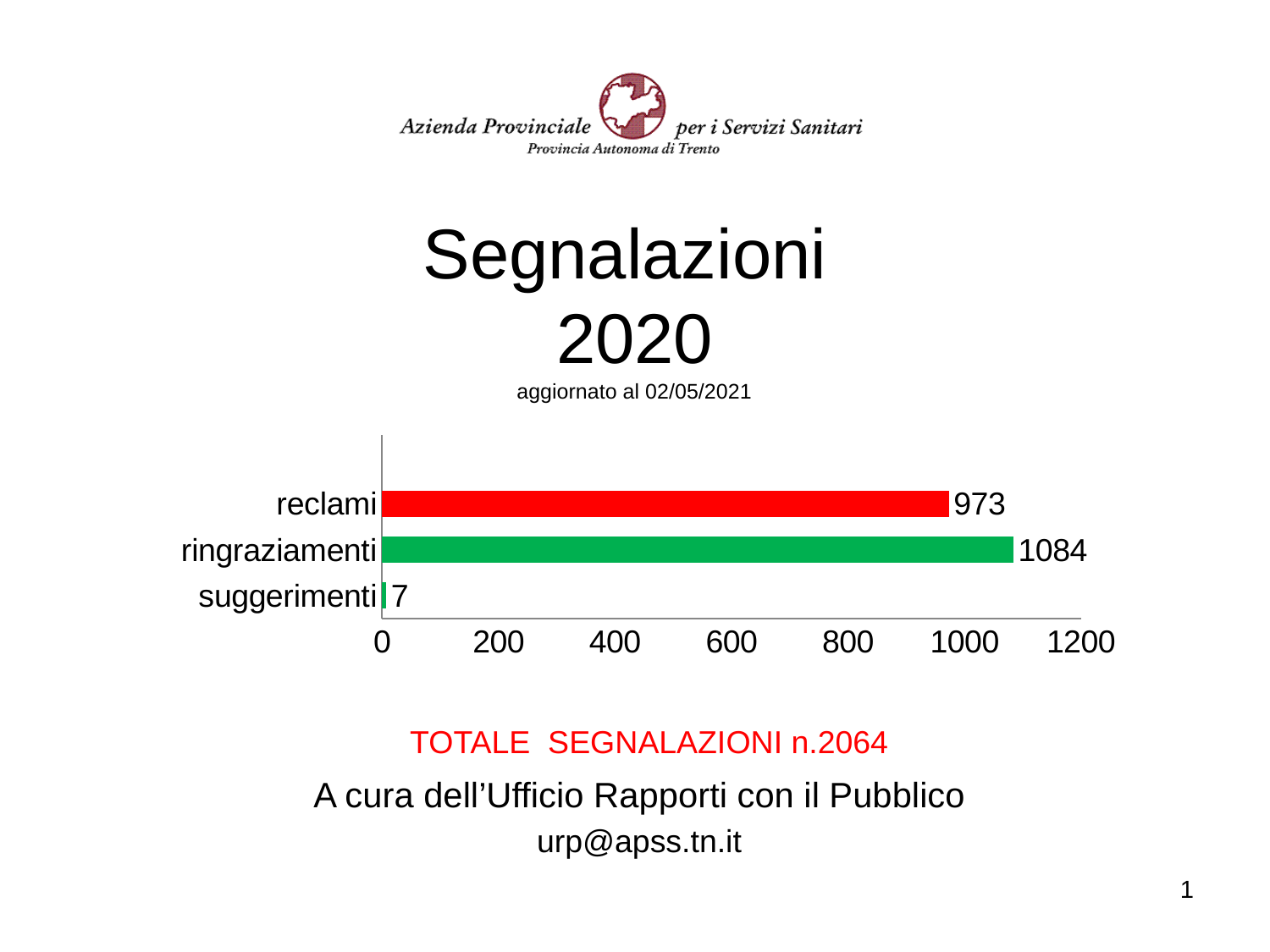
What is the difference between the values for ringraziamenti and reclami? 111 Is the value for reclami greater or less than 800? greater Which category has the highest value? ringraziamenti How many categories are shown in the chart? 3 Which category has the lowest value? suggerimenti What colour is the bar for ringraziamenti? green What is the value for suggerimenti? 7 What kind of chart is shown on the slide? bar chart Which is larger, the value for reclami or the value for ringraziamenti? ringraziamenti What is the total of the three values shown in the chart? 2064 What is the value for reclami? 973 What is the value for ringraziamenti? 1084